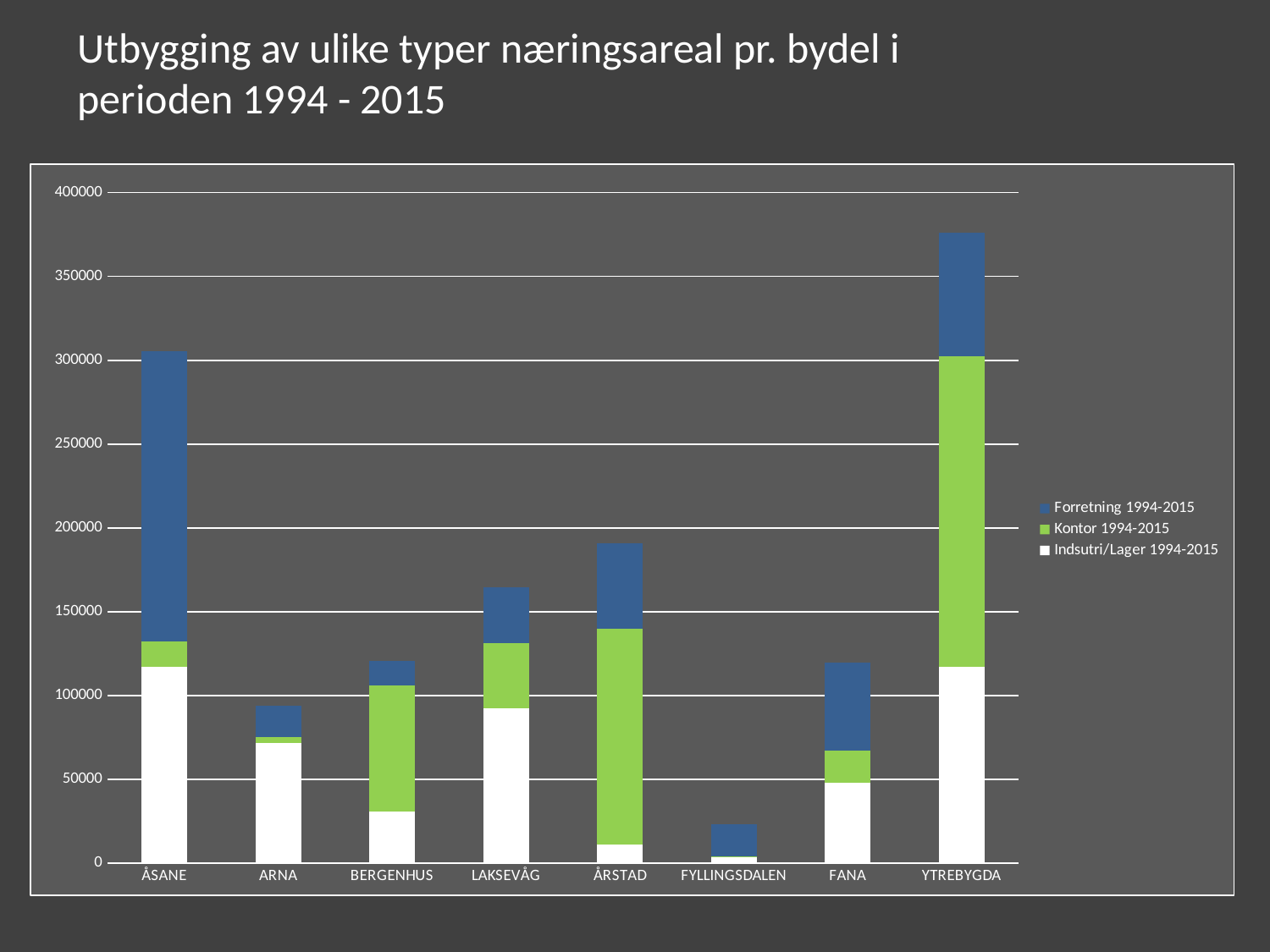
Which bydel has the highest total bar? YTREBYGDA How many series does the legend list? 3 Is the total value for YTREBYGDA greater or less than 350000? greater Is the total value for FYLLINGSDALEN greater or less than 50000? less Is the total value for ÅRSTAD greater or less than 150000? greater How many bydeler (categories) are shown on the x axis? 8 Which series is shown in green in the legend? Kontor 1994-2015 Which has the larger total bar, ÅSANE or ÅRSTAD? ÅSANE Which bydel has the largest Forretning 1994-2015 segment? ÅSANE What kind of chart is shown on the slide? Stacked bar chart Which bydel has the lowest total bar? FYLLINGSDALEN